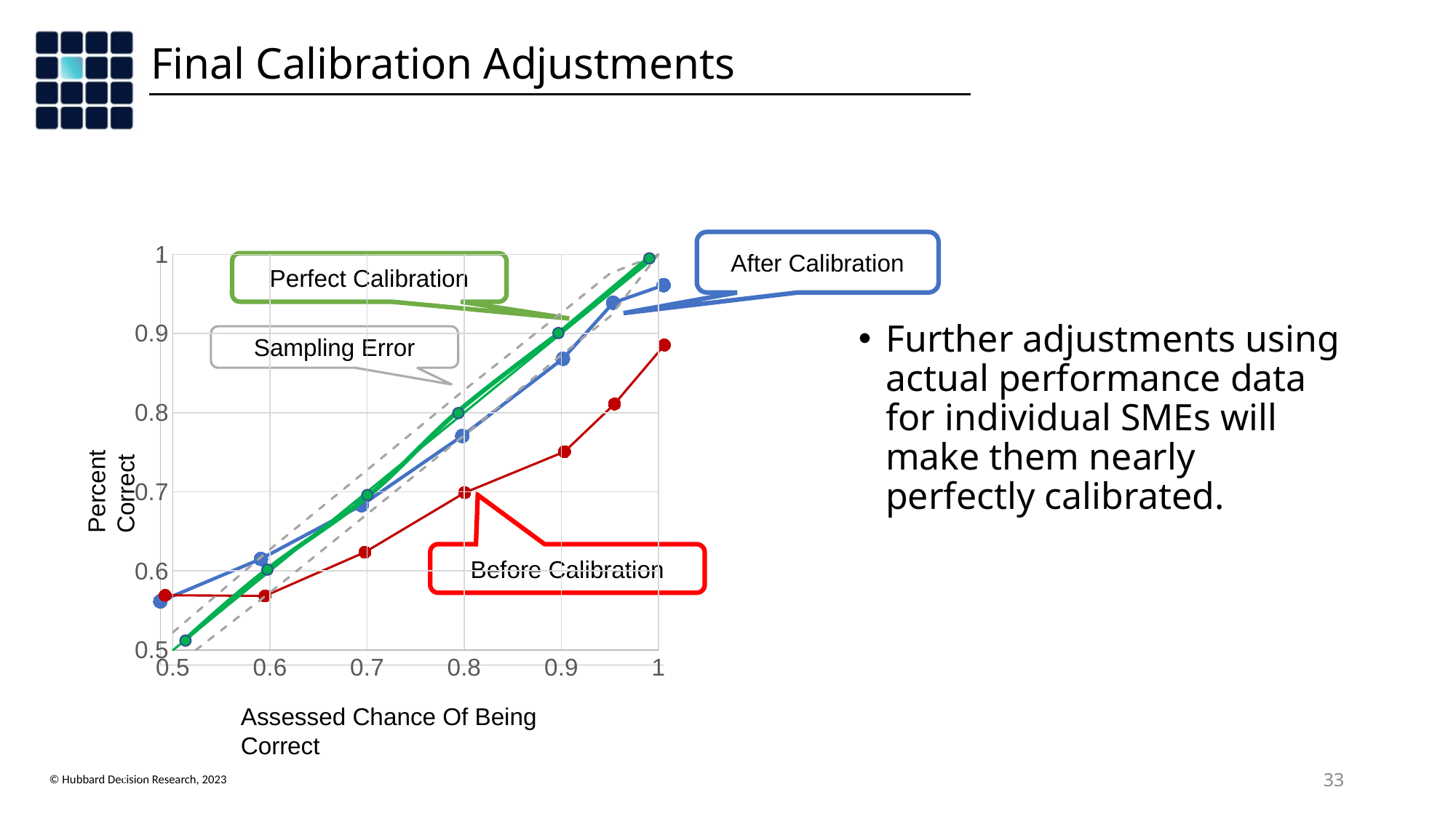
How many labelled data series does the chart show (excluding the dashed sampling error lines)? 3 Which series has the lowest Percent Correct at an assessed chance of 1? Before Calibration Does the Before Calibration line generally rise or fall as the assessed chance increases from 0.6 to 1? rise What is the label of the x axis? Assessed Chance Of Being Correct What is the Percent Correct for the Perfect Calibration line at an assessed chance of 0.8? 0.8 What is the Percent Correct for the Perfect Calibration line at an assessed chance of 1? 1 What kind of chart is shown on the slide? line chart What is the label of the y axis? Percent Correct Is the Percent Correct for Before Calibration at an assessed chance of 1 greater or less than 0.9? less At an assessed chance of 0.9, which has the higher Percent Correct: Before Calibration or After Calibration? After Calibration Is the Percent Correct for Before Calibration at an assessed chance of 0.9 greater or less than 0.8? less Is the Percent Correct for After Calibration at an assessed chance of 1 greater or less than 0.9? greater